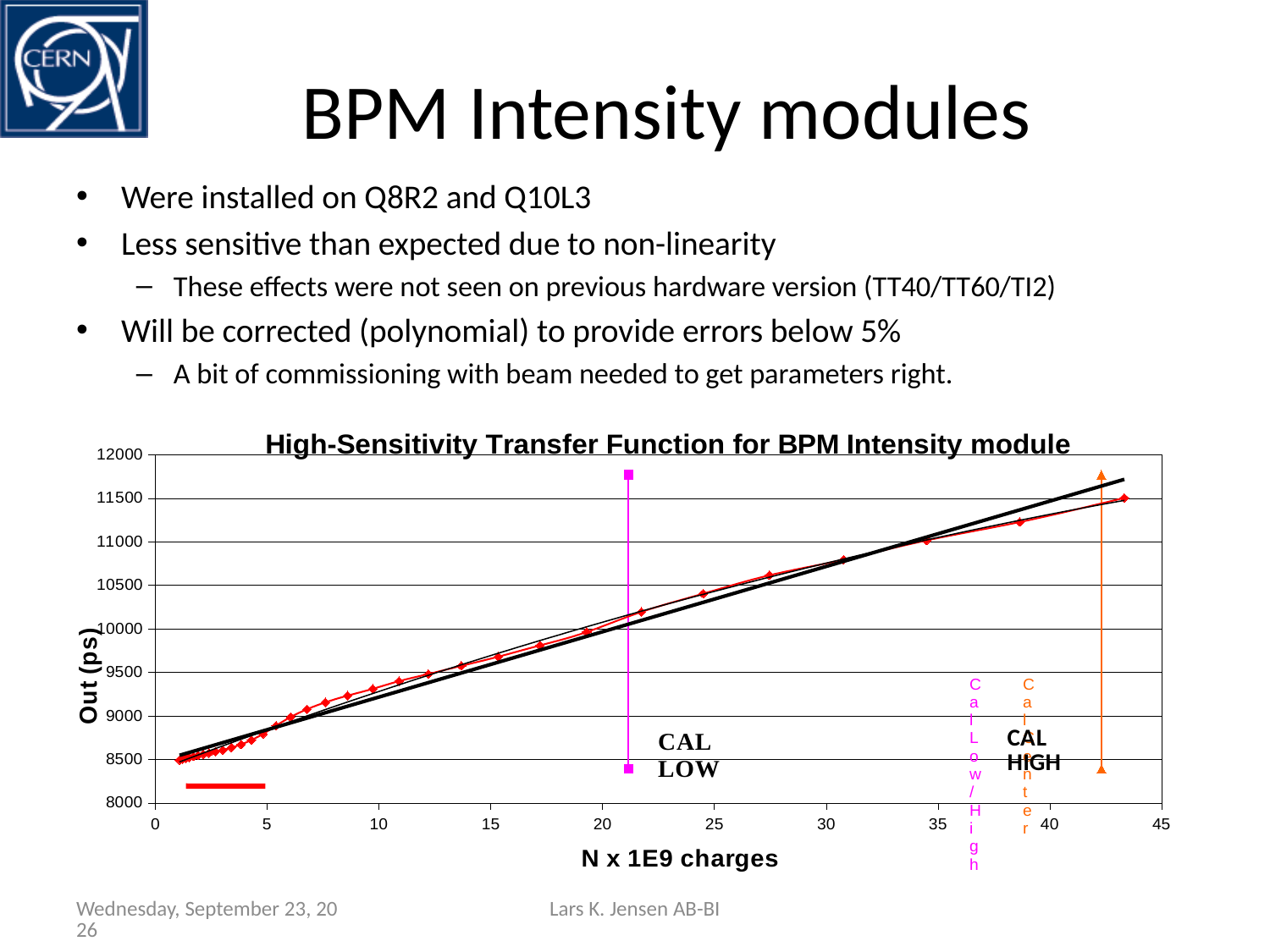
Is the plotted Out (ps) value at about 25 on the x axis greater or less than 10000? greater Is the plotted Out (ps) value at about 30 on the x axis greater or less than 10500? greater Is the plotted Out (ps) value at about 40 on the x axis greater or less than 11000? greater Do the plotted values rise or fall as N x 1E9 charges increases along the x axis? rise What kind of chart is shown on the slide? line chart What is the highest value shown on the y axis of the chart? 12000 What is the title of the chart on the slide? High-Sensitivity Transfer Function for BPM Intensity module What is the label of the y axis of the chart? Out (ps)